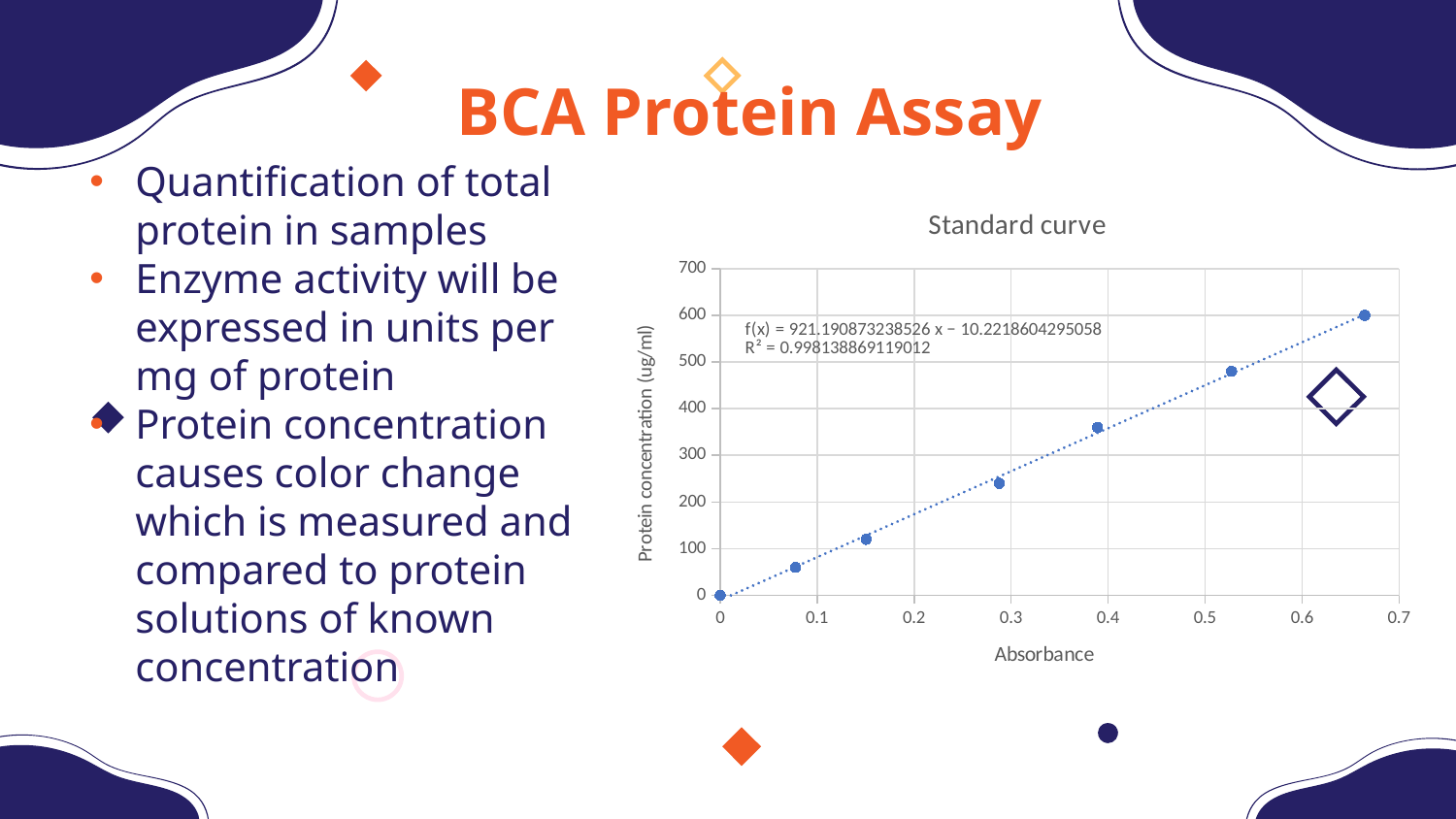
What is the trendline equation printed on the chart? f(x) = 921.190873238526 x − 10.2218604295058 Is the protein concentration of the data point at an absorbance of about 0.08 greater or less than 100? less What kind of chart is shown on the slide? scatter chart Is the protein concentration of the data point at an absorbance of about 0.39 greater or less than 300? greater Is the protein concentration of the rightmost data point (highest absorbance) greater or less than 500? greater What is the label of the x axis of the chart? Absorbance What R² value is printed on the chart? 0.998138869119012 Which data point has the lowest protein concentration: the one at absorbance 0 or the one at absorbance about 0.67? the one at absorbance 0 How many data points are plotted on the chart? 7 Do the plotted protein concentration values rise or fall as absorbance increases along the x axis? rise What is the highest value shown on the y axis of the chart? 700 What is the title of the chart? Standard curve